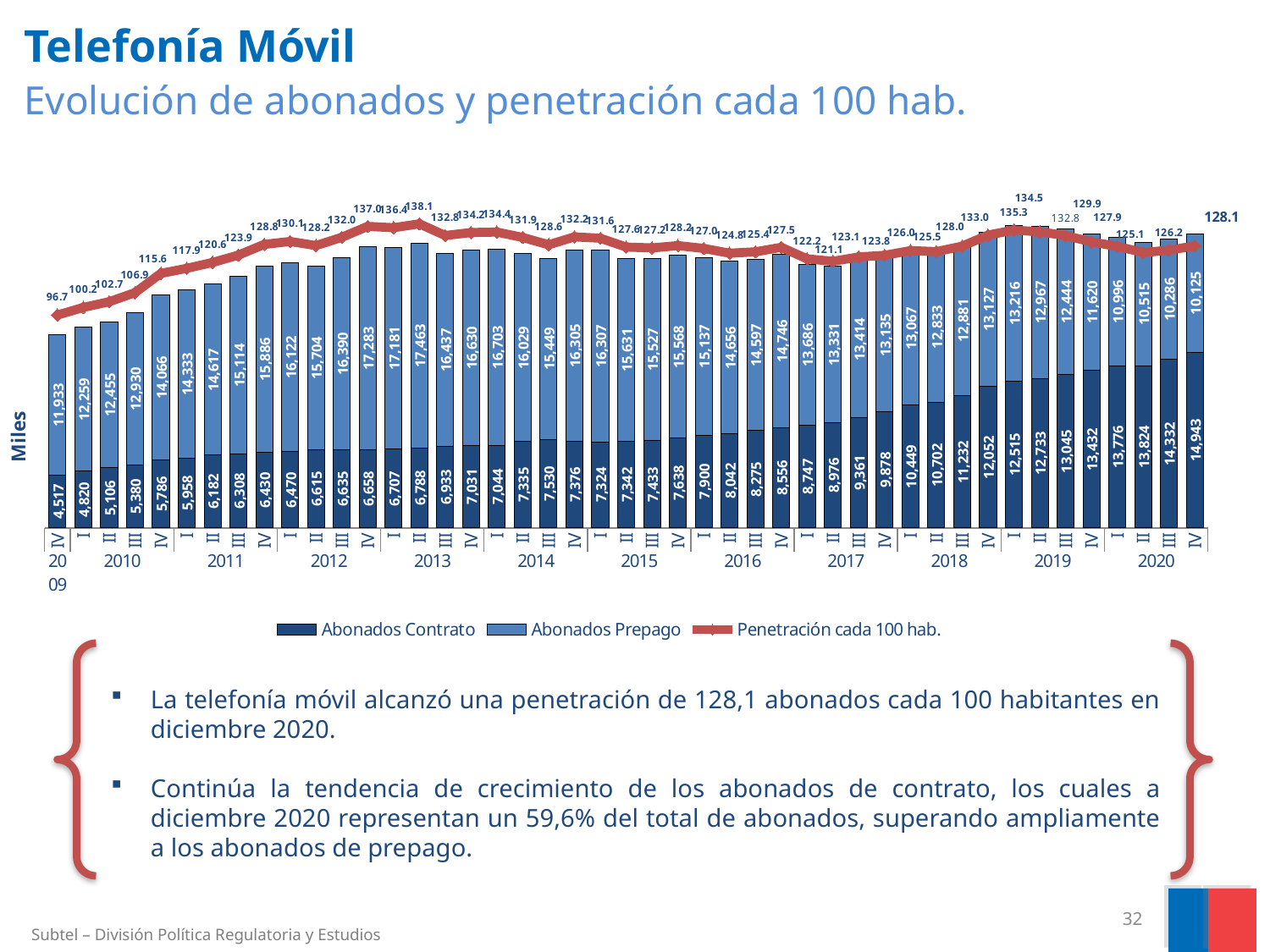
In IV 2009, which is larger: Abonados Contrato or Abonados Prepago? Abonados Prepago Do the Abonados Contrato values rise or fall from IV 2009 to IV 2020? Rise What is the difference between Abonados Contrato and Abonados Prepago in IV 2020? 4,818 In which quarter is Abonados Contrato lowest? IV 2009 What is the Penetración cada 100 hab. value for IV 2020? 128.1 What is the total of Abonados Contrato and Abonados Prepago for IV 2020? 25,068 What is the value of Abonados Prepago for IV 2020? 10,125 How many series does the legend list? 3 In which quarter is Abonados Prepago highest? II 2013 What is the value of Abonados Contrato for IV 2020? 14,943 What is the Penetración cada 100 hab. value for IV 2009? 96.7 In which quarter does Penetración cada 100 hab. reach its highest value? II 2013